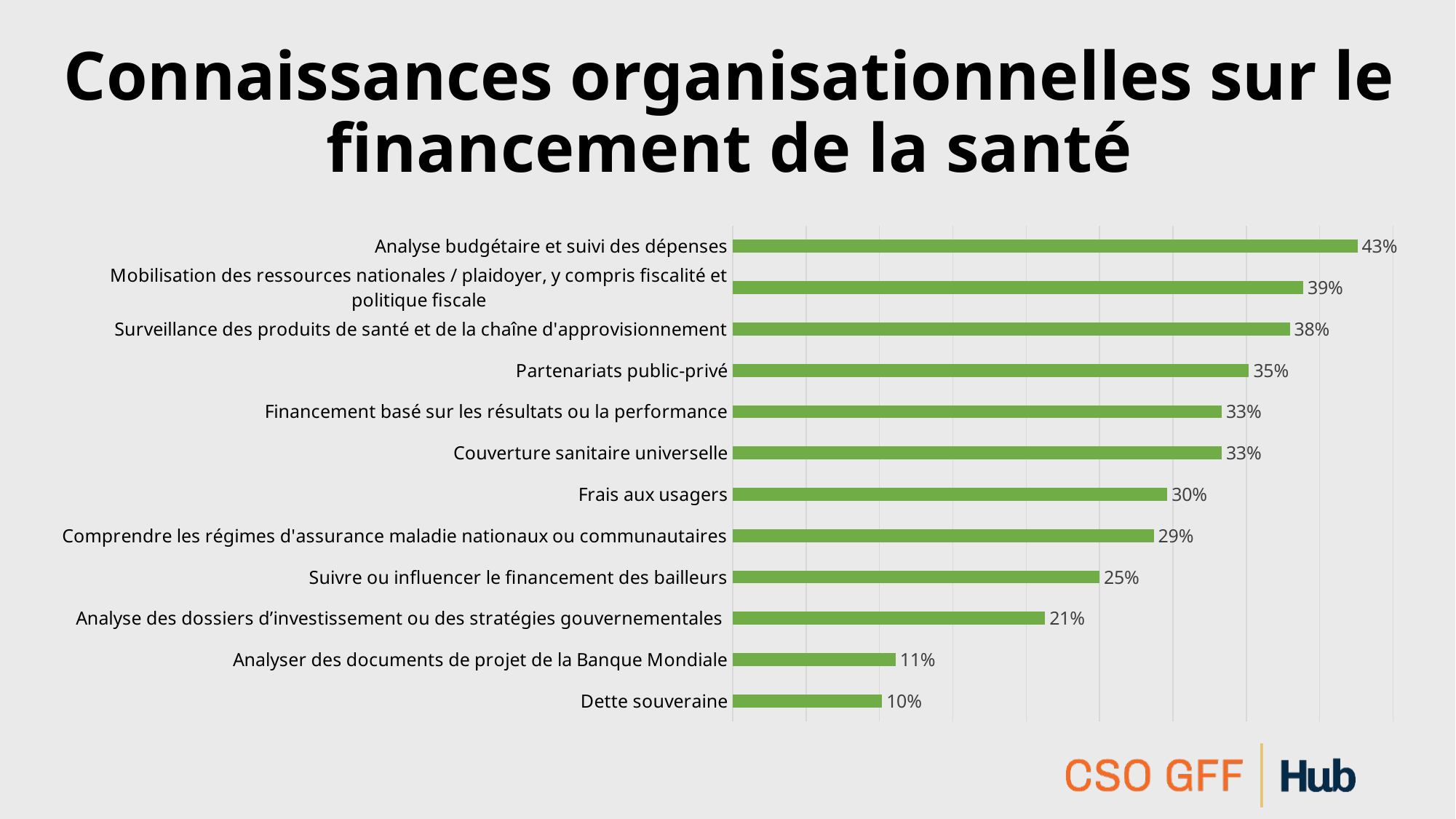
How many categories are shown in the chart? 12 What is the value for "Dette souveraine"? 10% Which is larger: "Surveillance des produits de santé et de la chaîne d'approvisionnement" or "Analyse des dossiers d'investissement ou des stratégies gouvernementales"? Surveillance des produits de santé et de la chaîne d'approvisionnement What is the value for "Partenariats public-privé"? 35% What kind of chart is shown on the slide? Bar chart What is the title of the slide? Connaissances organisationnelles sur le financement de la santé What is the difference between "Frais aux usagers" and "Analyser des documents de projet de la Banque Mondiale"? 19 percentage points What is the value for "Suivre ou influencer le financement des bailleurs"? 25% What is the value for "Analyse budgétaire et suivi des dépenses"? 43% Which category has the highest value? Analyse budgétaire et suivi des dépenses Which category has the lowest value? Dette souveraine What is the difference between "Analyse budgétaire et suivi des dépenses" and "Dette souveraine"? 33 percentage points